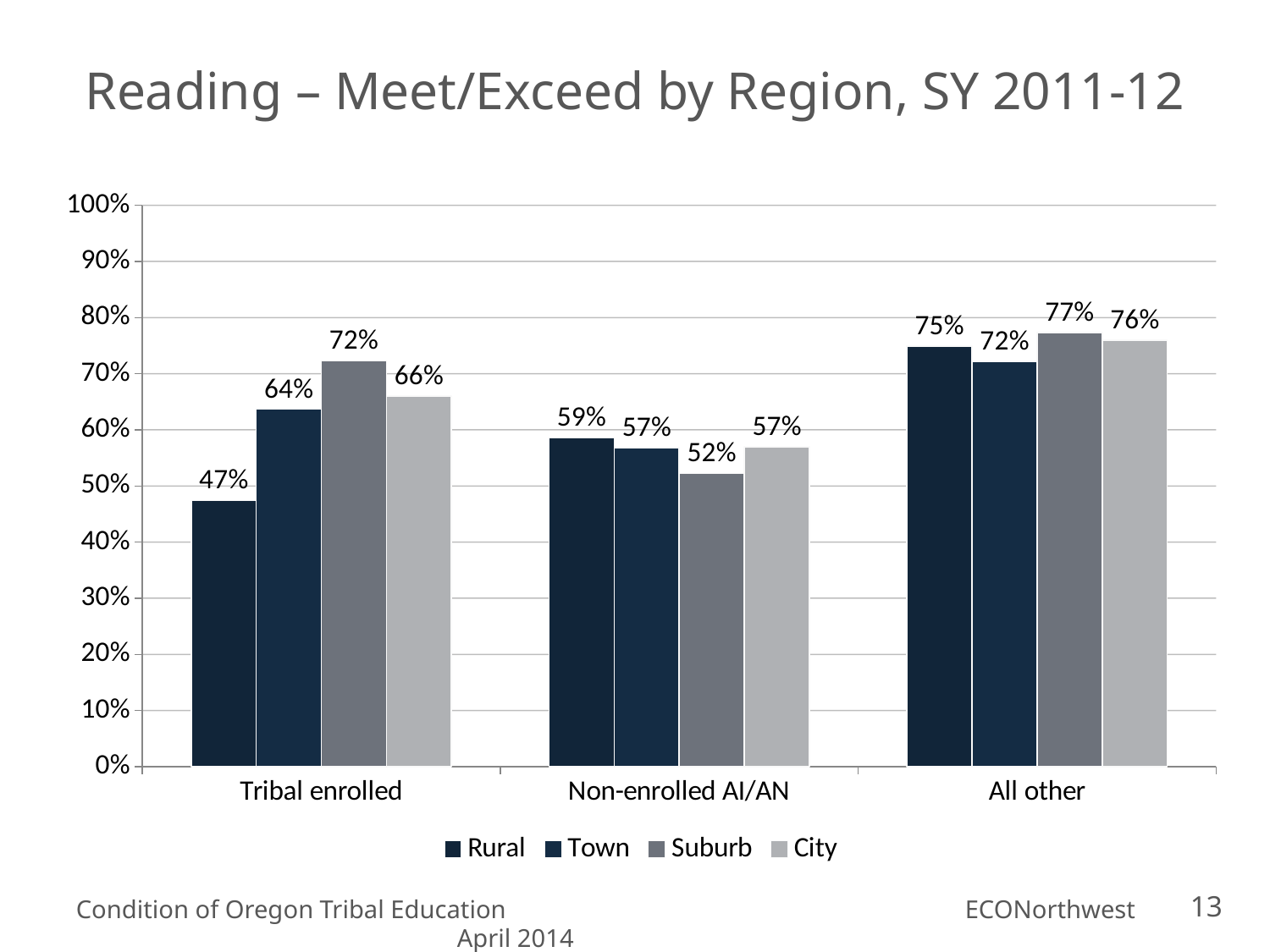
What kind of chart is shown on the slide? Bar chart How many series does the legend list? 4 What is the title of the chart? Reading – Meet/Exceed by Region, SY 2011-12 Which region has the highest value for Tribal enrolled? Suburb Does the Rural value rise or fall from Tribal enrolled to All other? Rise What is the Suburb value for Non-enrolled AI/AN? 52% What is the City value for All other? 76% How many categories are shown on the x axis? 3 Which region has the lowest value for Non-enrolled AI/AN? Suburb What is the Rural value for Tribal enrolled? 47% What is the difference between the Suburb and Rural values for Tribal enrolled? 25% Which is larger for All other: the Rural value or the Town value? Rural